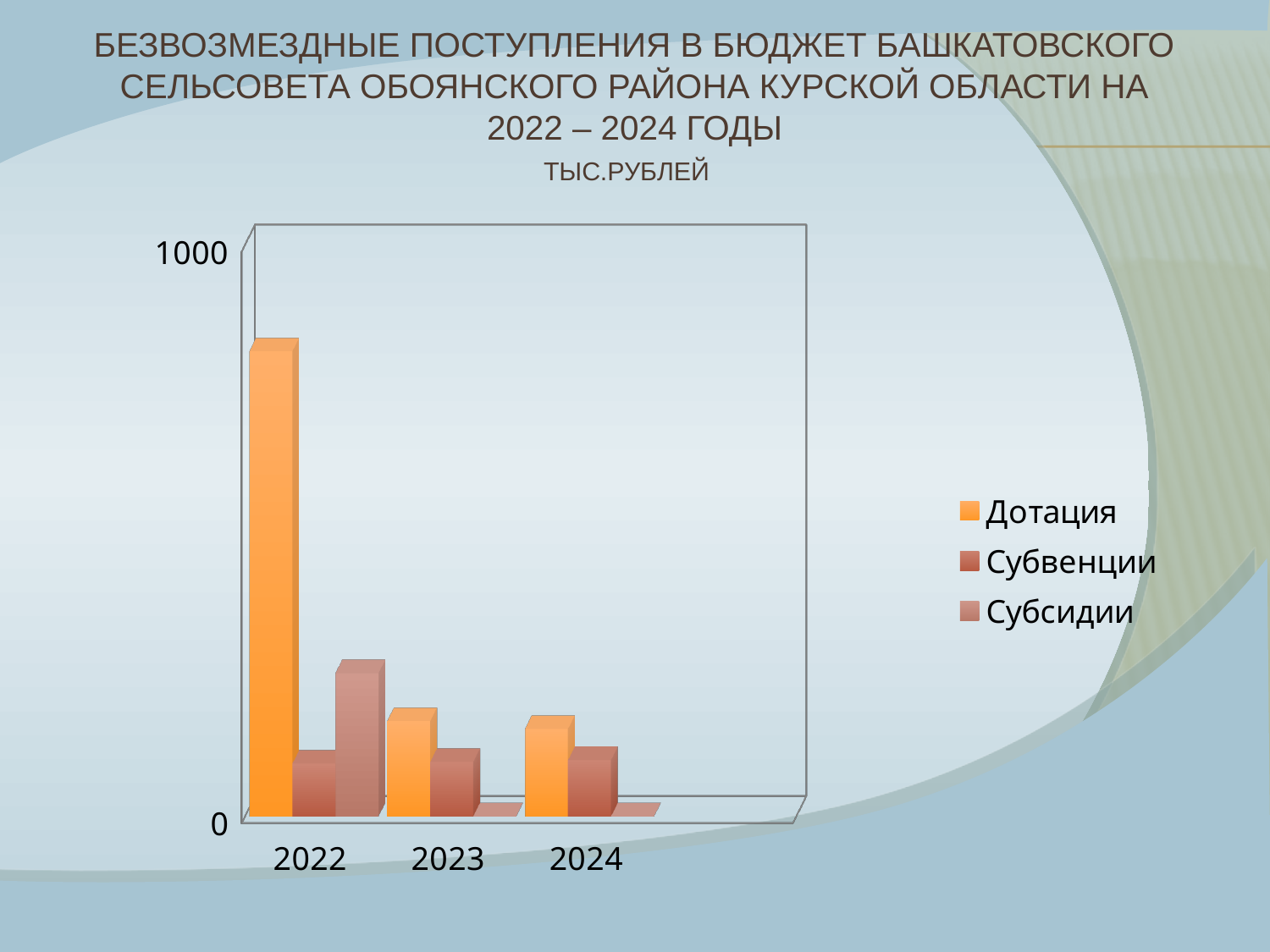
Is the value for Дотация in 2022 greater or less than 1000? less What kind of chart is shown on the slide? bar chart In what units are the values of the chart given, according to the subtitle? тыс.рублей Does the Субсидии value rise or fall from 2022 to 2024? fall Which is larger in 2022: Субвенции or Субсидии? Субсидии Which is larger: Дотация in 2022 or Дотация in 2023? Дотация in 2022 Which series has the highest bar in the chart? Дотация In which year is the Дотация bar the highest? 2022 How many series does the chart's legend list? 3 Does the Дотация value rise or fall from 2022 to 2024? fall How many years are shown on the x axis of the chart? 3